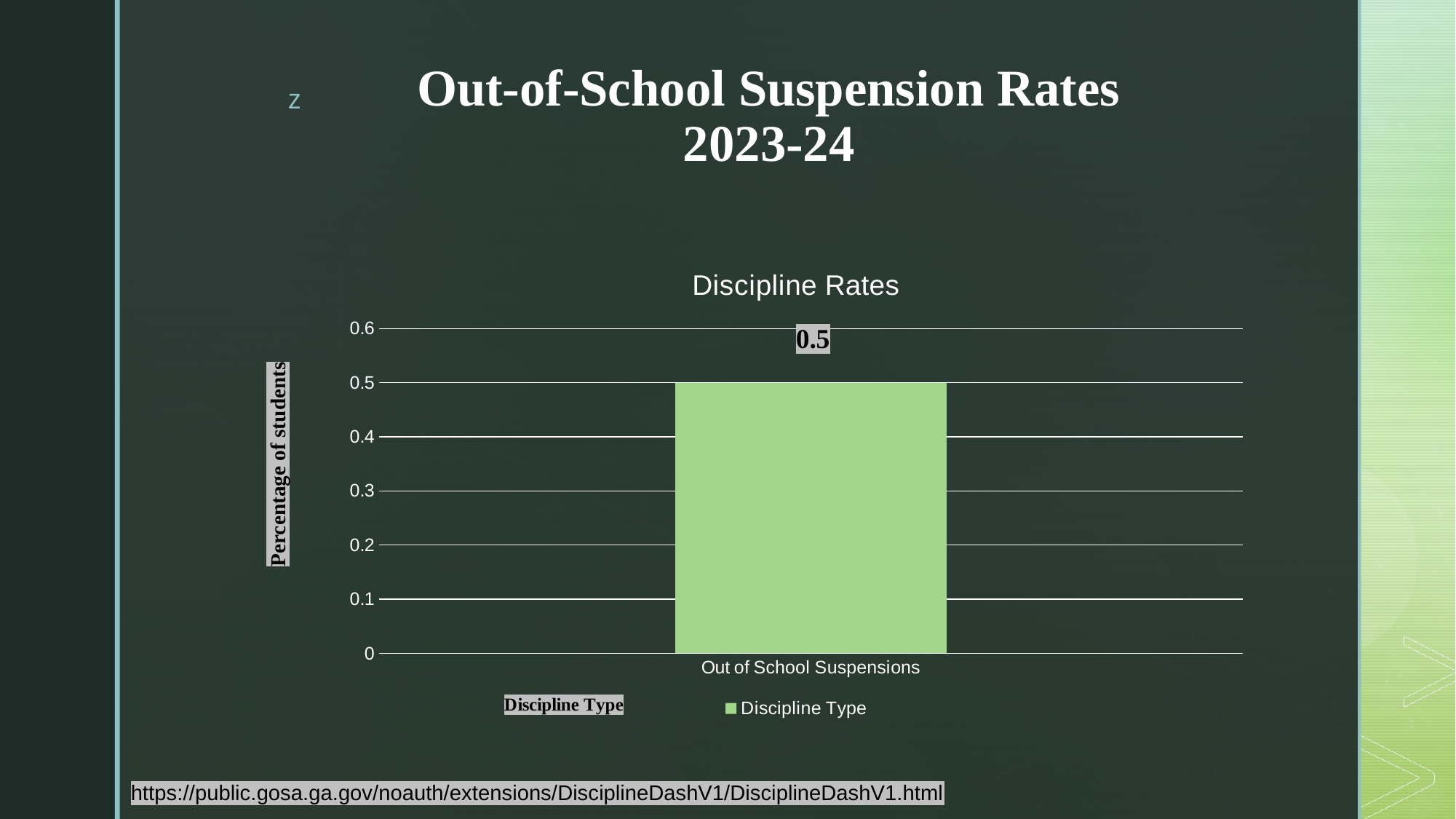
Is the value for Out of School Suspensions greater or less than 0.6? less What is the value for Out of School Suspensions in the Discipline Rates chart? 0.5 What is the label of the vertical axis in the Discipline Rates chart? Percentage of students Is the value for Out of School Suspensions greater or less than 0.4? greater How many categories are plotted in the Discipline Rates chart? 1 What type of chart is shown on the slide? bar chart What is the name of the series shown in the legend of the Discipline Rates chart? Discipline Type How many series does the legend of the Discipline Rates chart list? 1 What is the highest value shown on the vertical axis of the Discipline Rates chart? 0.6 What is the title of the chart on the slide? Discipline Rates